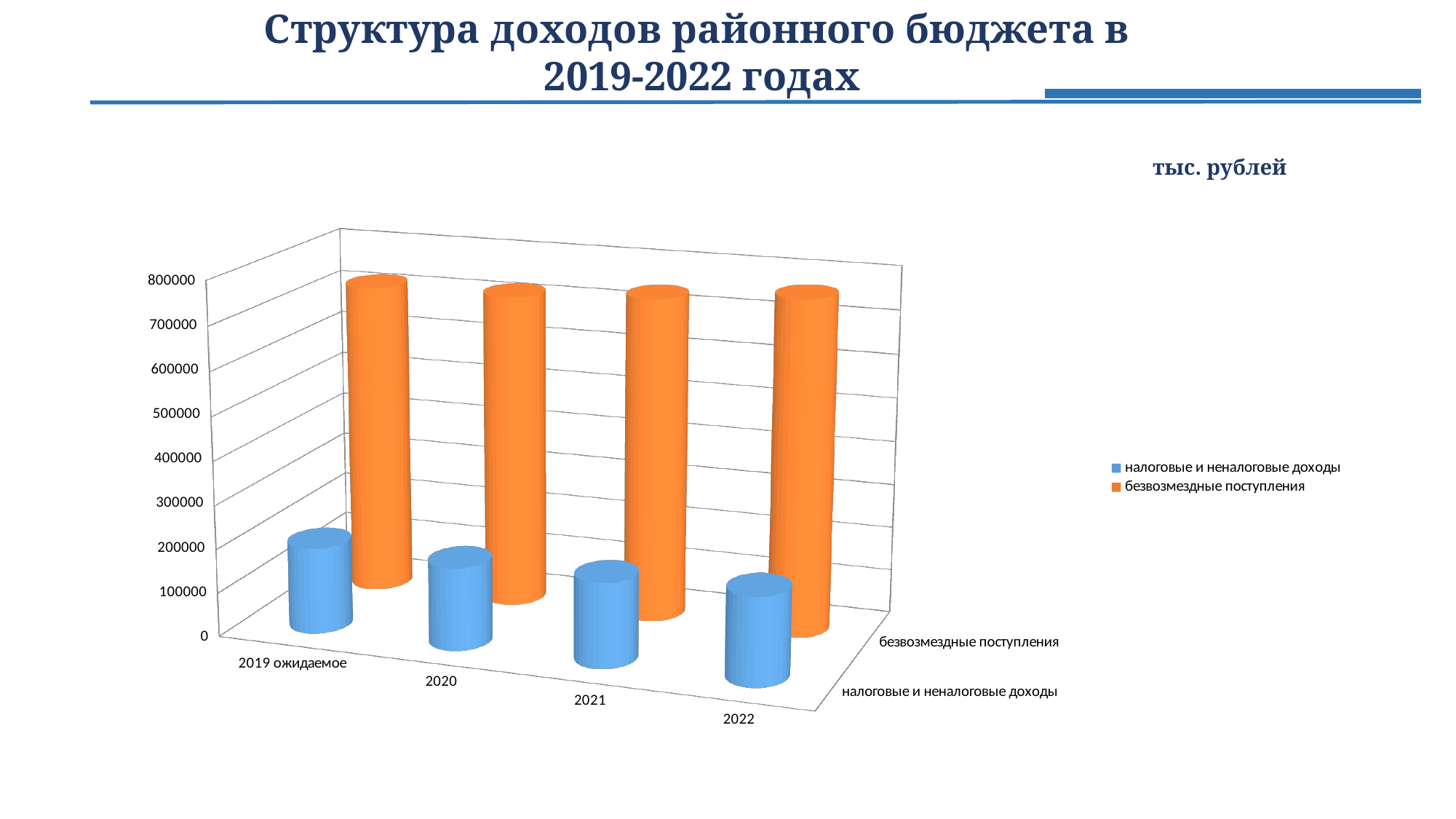
Is the value for безвозмездные поступления in 2019 ожидаемое greater or less than 500000? greater What colour represents безвозмездные поступления in the chart? orange How many series does the legend list? 2 Which series is larger in 2020: налоговые и неналоговые доходы or безвозмездные поступления? безвозмездные поступления What unit is indicated for the chart values? тыс. рублей How many year categories are shown on the x axis? 4 What kind of chart is shown on the slide? bar chart Which series is larger in 2022: налоговые и неналоговые доходы or безвозмездные поступления? безвозмездные поступления Is the value for налоговые и неналоговые доходы in 2019 ожидаемое greater or less than 400000? less Is the value for безвозмездные поступления in 2022 greater or less than 400000? greater